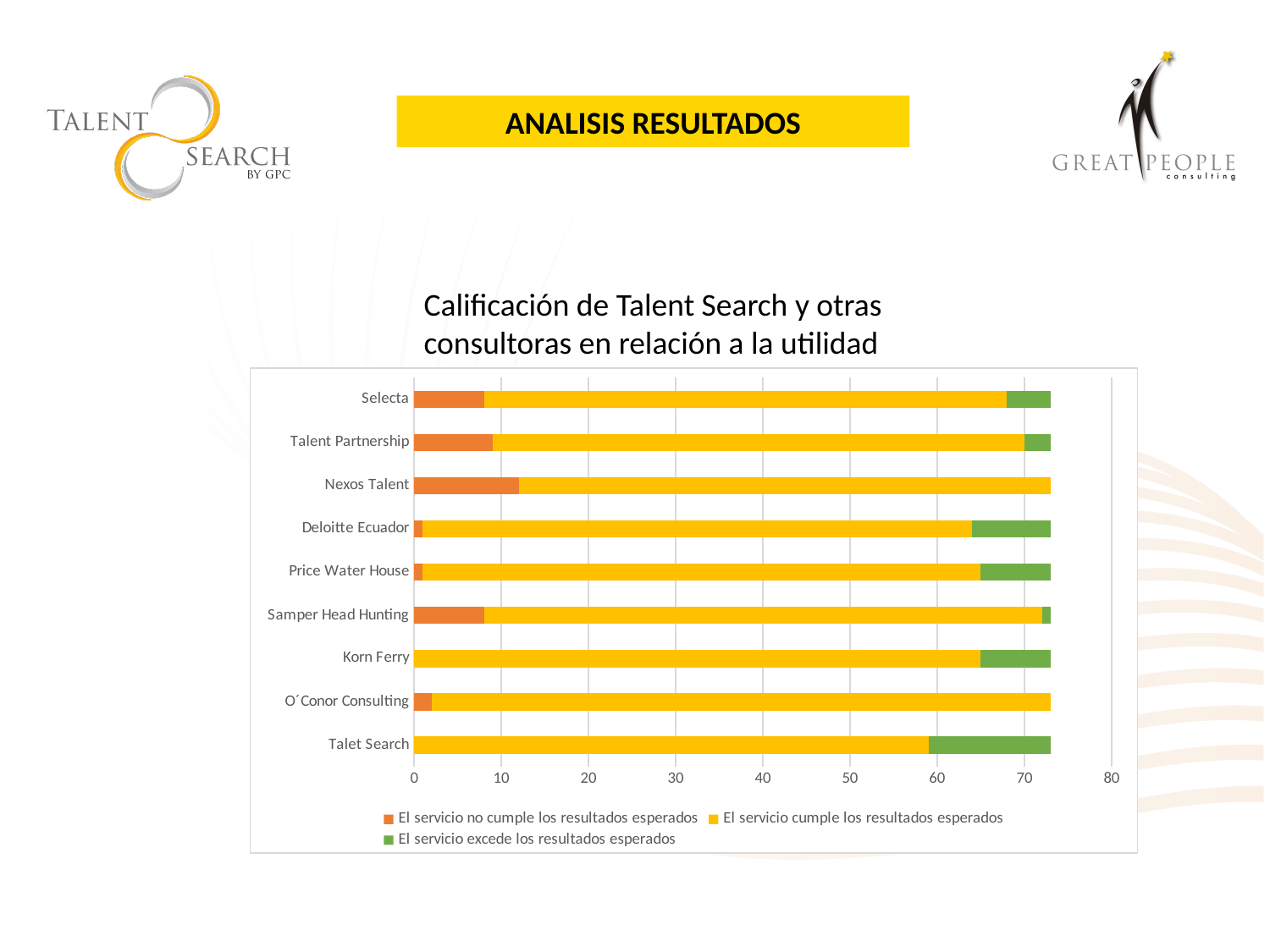
Is the total length of the bar for Talet Search greater or less than 70? greater Which firm has the larger 'El servicio excede los resultados esperados' segment, Talet Search or Talent Partnership? Talet Search How many consulting firms (categories) are listed on the vertical axis of the chart? 9 Which firm has the largest 'El servicio excede los resultados esperados' segment? Talet Search Is the 'El servicio no cumple los resultados esperados' segment for Nexos Talent greater or less than 10? greater What is the title of the chart? Calificación de Talent Search y otras consultoras en relación a la utilidad Which firm has the larger 'El servicio no cumple los resultados esperados' segment, Nexos Talent or Selecta? Nexos Talent What kind of chart is shown on the slide? Stacked bar chart How many series does the chart legend list? 3 Is the 'El servicio no cumple los resultados esperados' segment for Selecta greater or less than 10? less Which firm has the largest 'El servicio no cumple los resultados esperados' segment? Nexos Talent Which series in the legend is shown in green? El servicio excede los resultados esperados